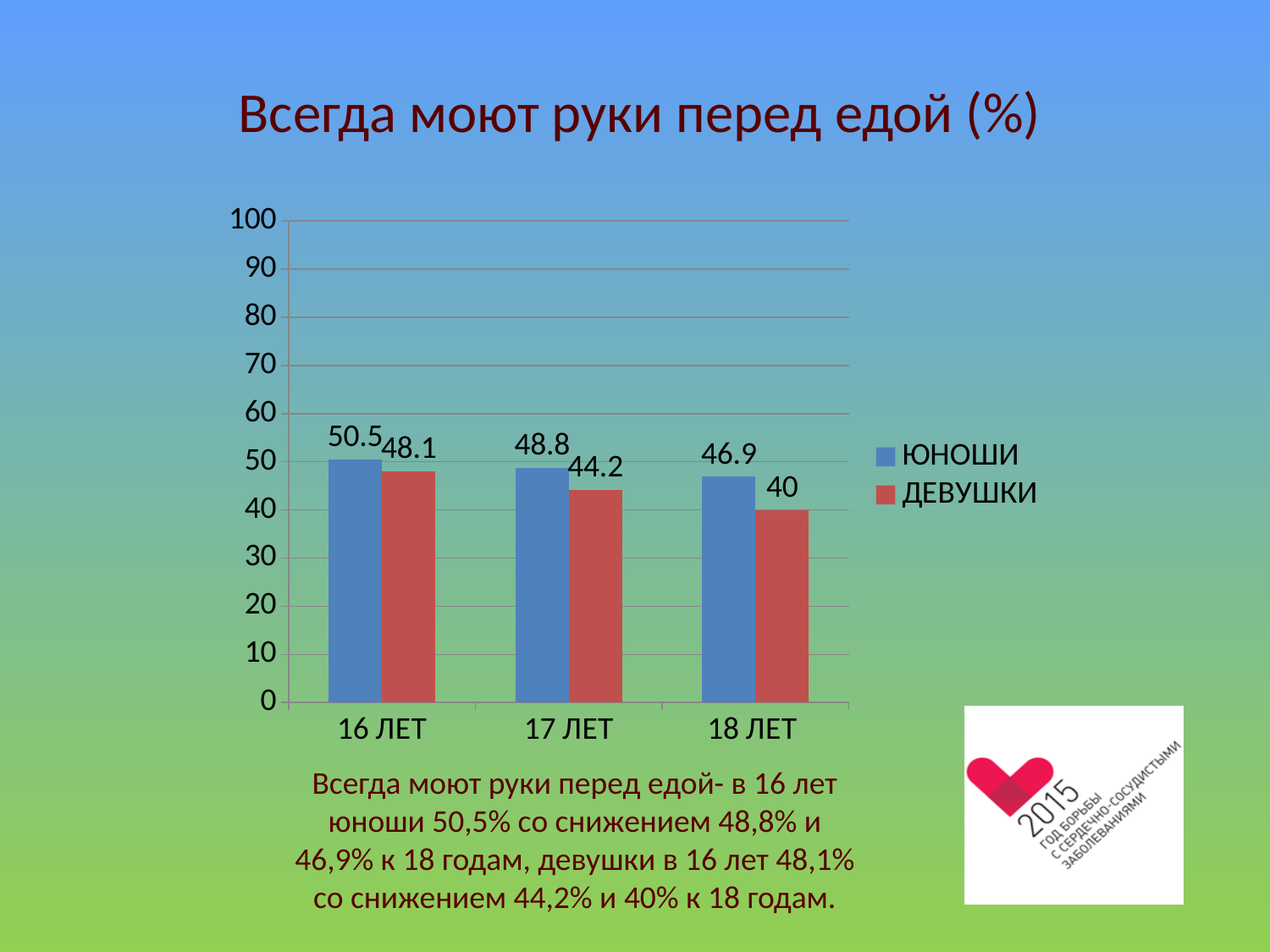
What is the value for ЮНОШИ at 16 ЛЕТ? 50.5 Which is larger at 17 ЛЕТ, ЮНОШИ or ДЕВУШКИ? ЮНОШИ Which age group has the highest value for ЮНОШИ? 16 ЛЕТ Which age group has the lowest value for ДЕВУШКИ? 18 ЛЕТ Is the value for ДЕВУШКИ at 16 ЛЕТ greater or less than 50? less What kind of chart is shown on the slide? bar chart How many age categories are shown on the x axis? 3 How many series does the legend list? 2 What is the value for ДЕВУШКИ at 17 ЛЕТ? 44.2 What is the difference between ЮНОШИ and ДЕВУШКИ at 18 ЛЕТ? 6.9 What is the value for ДЕВУШКИ at 18 ЛЕТ? 40 Do the values for ДЕВУШКИ rise or fall from 16 ЛЕТ to 18 ЛЕТ? fall